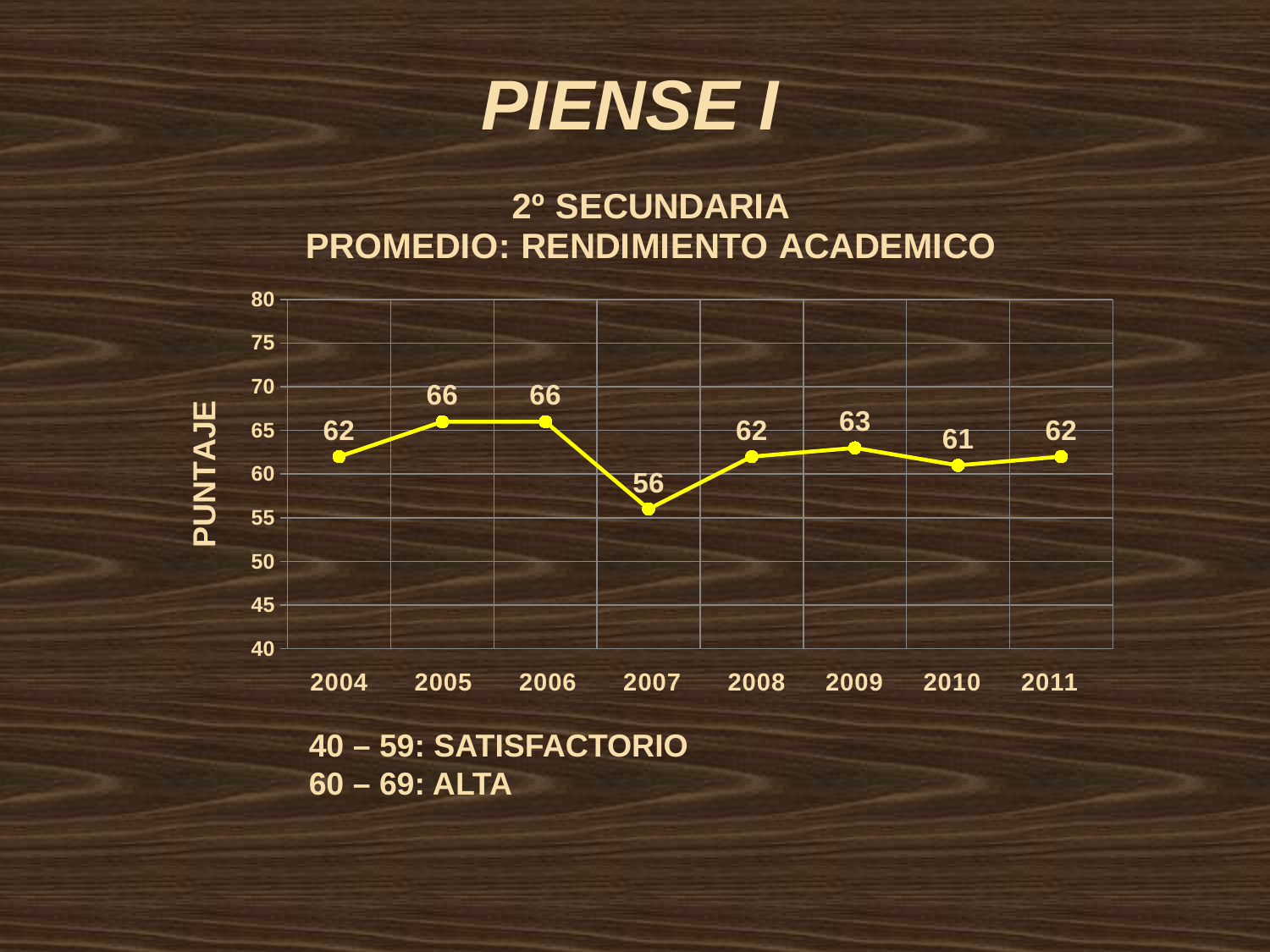
What is the label on the vertical axis? PUNTAJE What is the value for 2007? 56 Which is larger, the value for 2005 or the value for 2008? 2005 Do the values rise or fall from 2007 to 2009? rise What is the value for 2009? 63 How many years are plotted on the chart? 8 What is the difference between the values for 2009 and 2010? 2 What is the difference between the values for 2006 and 2007? 10 What kind of chart is shown? line chart Which year has the lowest value? 2007 What is the value for 2010? 61 Is the value for 2007 greater or less than 60? less